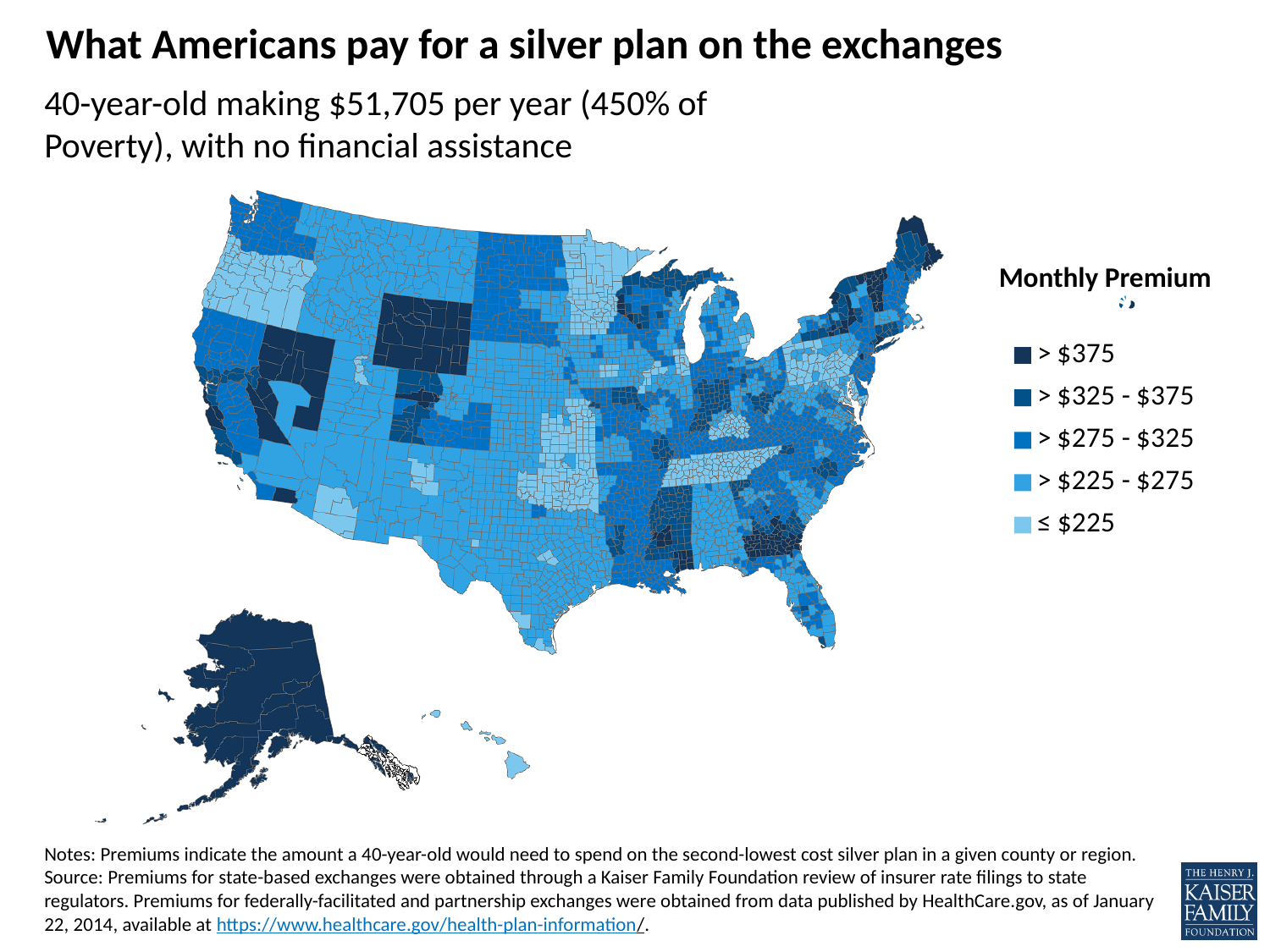
How many premium categories does the map legend list? 5 Which legend category is shown in the darkest shade of blue? > $375 What is the title of the map legend? Monthly Premium Is the monthly premium for Hawaii greater or less than $275? less What annual income does the subtitle say the 40-year-old makes? $51,705 per year What is the highest premium category shown in the legend? > $375 What kind of chart is shown on the slide? A map (choropleth map of the United States) Is the monthly premium for Alaska greater or less than $375? greater What is the lowest premium category shown in the legend? ≤ $225 Which monthly premium category does Alaska fall into on the map? > $375 Which monthly premium category does Hawaii fall into on the map? ≤ $225